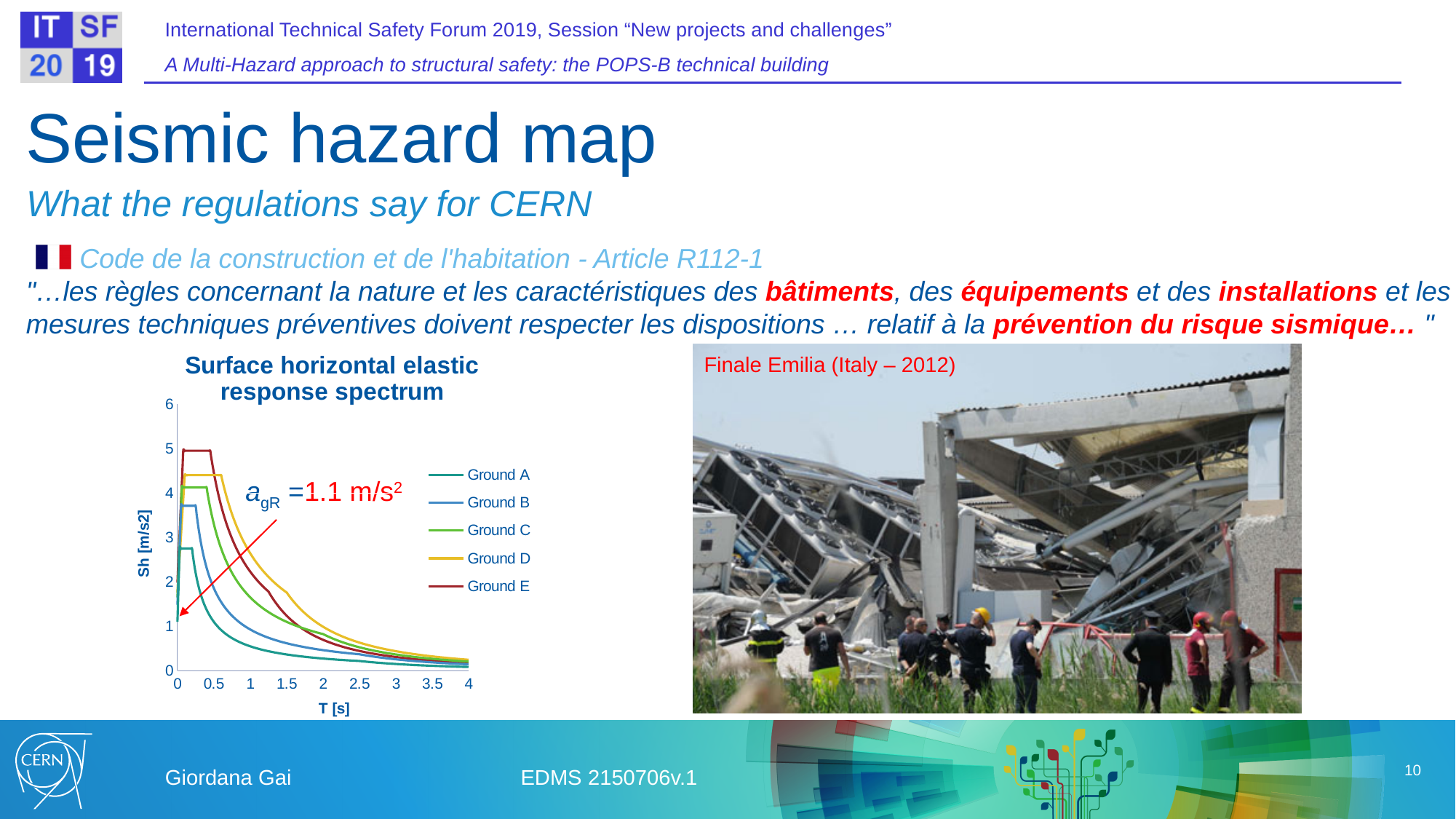
What value of a_gR is annotated on the response spectrum chart? 1.1 m/s2 In the response spectrum chart, which has the higher peak Sh value, Ground D or Ground B? Ground D What kind of chart is the 'Surface horizontal elastic response spectrum'? line chart In the response spectrum chart, do the Sh values rise or fall as T increases beyond about 0.5 s? fall In the response spectrum chart, which ground type reaches the highest peak value of Sh? Ground E What is the title of the chart on the left of the slide? Surface horizontal elastic response spectrum In the response spectrum chart, is the peak Sh value for Ground B greater or less than 3? greater In the response spectrum chart, which ground type has the lowest peak value of Sh? Ground A In the response spectrum chart, is the peak Sh value for Ground E greater or less than 4? greater In the response spectrum chart, is the peak Sh value for Ground A greater or less than 3? less What is the label of the y axis of the response spectrum chart? Sh [m/s2] How many series does the legend of the response spectrum chart list? 5